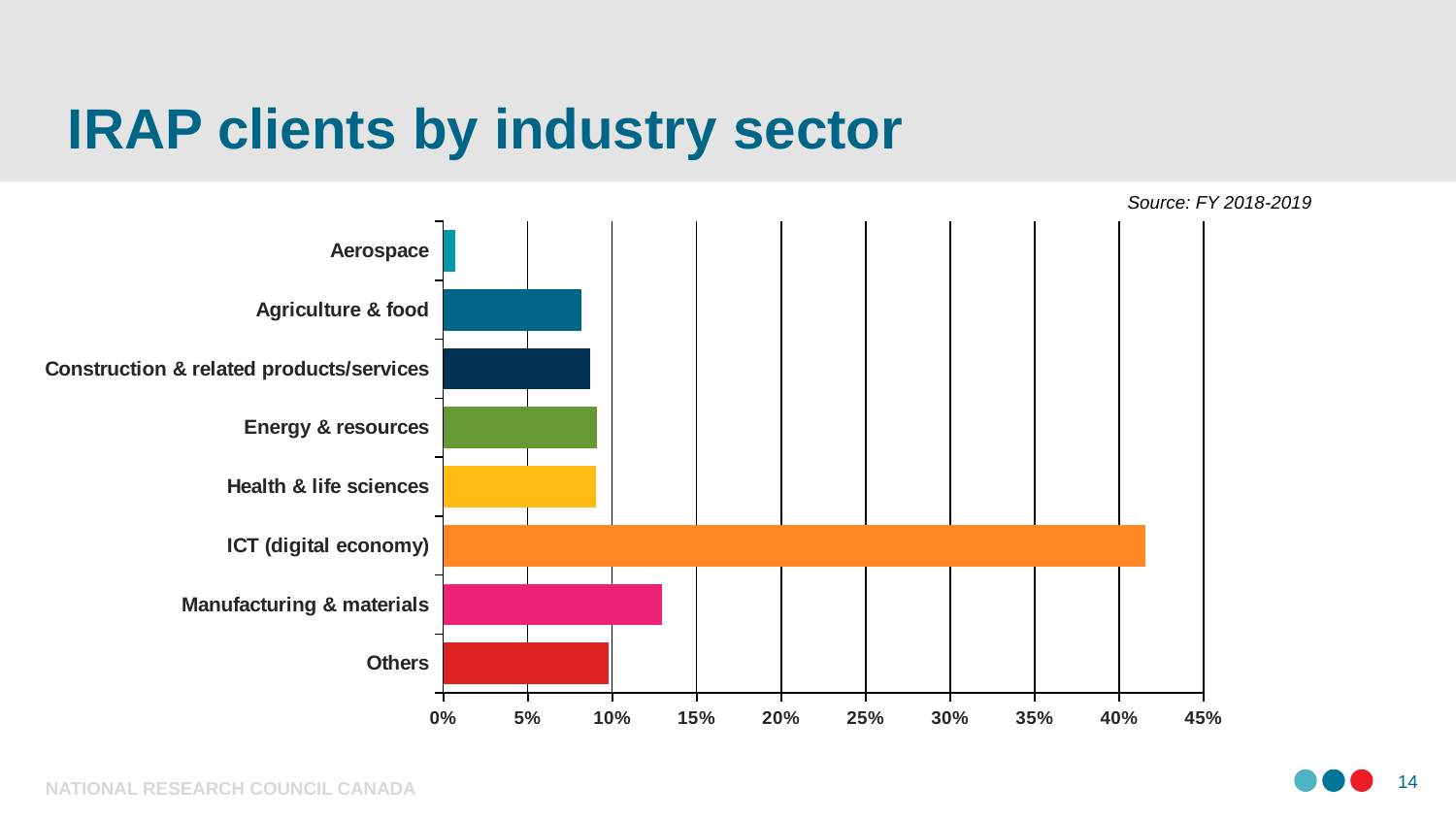
What fiscal year is given as the source of the chart data? FY 2018-2019 What kind of chart is shown on the slide? bar chart Is the value for Manufacturing & materials greater or less than 10%? greater Is the value for Agriculture & food greater or less than 10%? less Which industry sector has the highest share of IRAP clients? ICT (digital economy) Which is larger, the value for Manufacturing & materials or the value for Agriculture & food? Manufacturing & materials Which is larger, the value for ICT (digital economy) or the value for Manufacturing & materials? ICT (digital economy) What is the title of the slide containing the chart? IRAP clients by industry sector Is the value for ICT (digital economy) greater or less than 40%? greater How many industry sectors are shown in the chart? 8 Which industry sector has the lowest share of IRAP clients? Aerospace